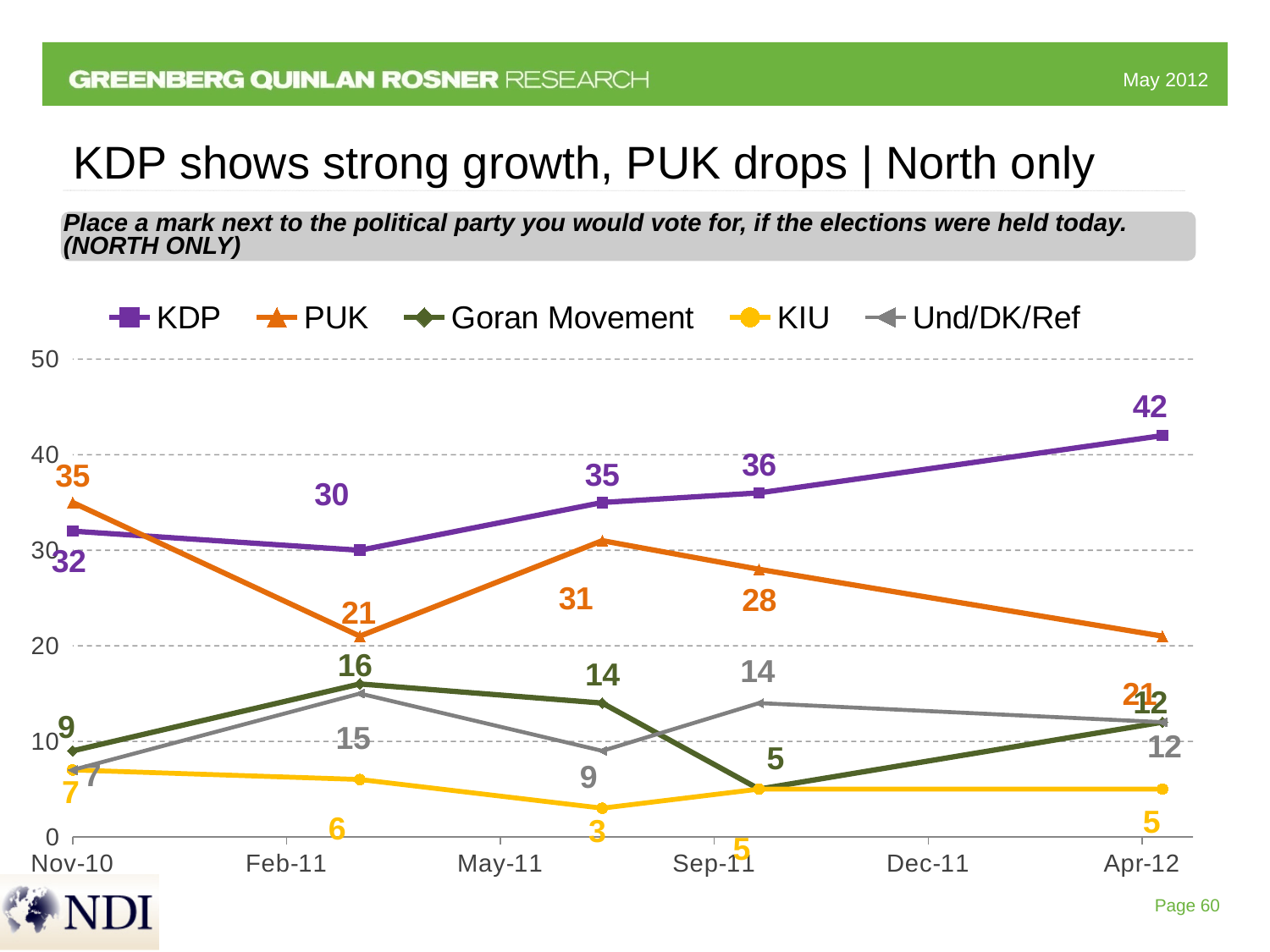
What is the value for Und/DK/Ref at Apr-12? 12 At Apr-12, which is larger, the value for KDP or the value for PUK? KDP What is the highest value plotted for KDP? 42 Does the KDP line rise or fall overall from Nov-10 to Apr-12? rise What is the value for KDP at Apr-12? 42 How many data points are plotted for each series? 5 By how much did the KDP value increase from Nov-10 to Apr-12? 10 What is the value for Goran Movement at Nov-10? 9 What is the lowest value plotted for KIU? 3 What kind of chart is shown on the slide? line chart How many series does the legend list? 5 What is the value for PUK at Nov-10? 35